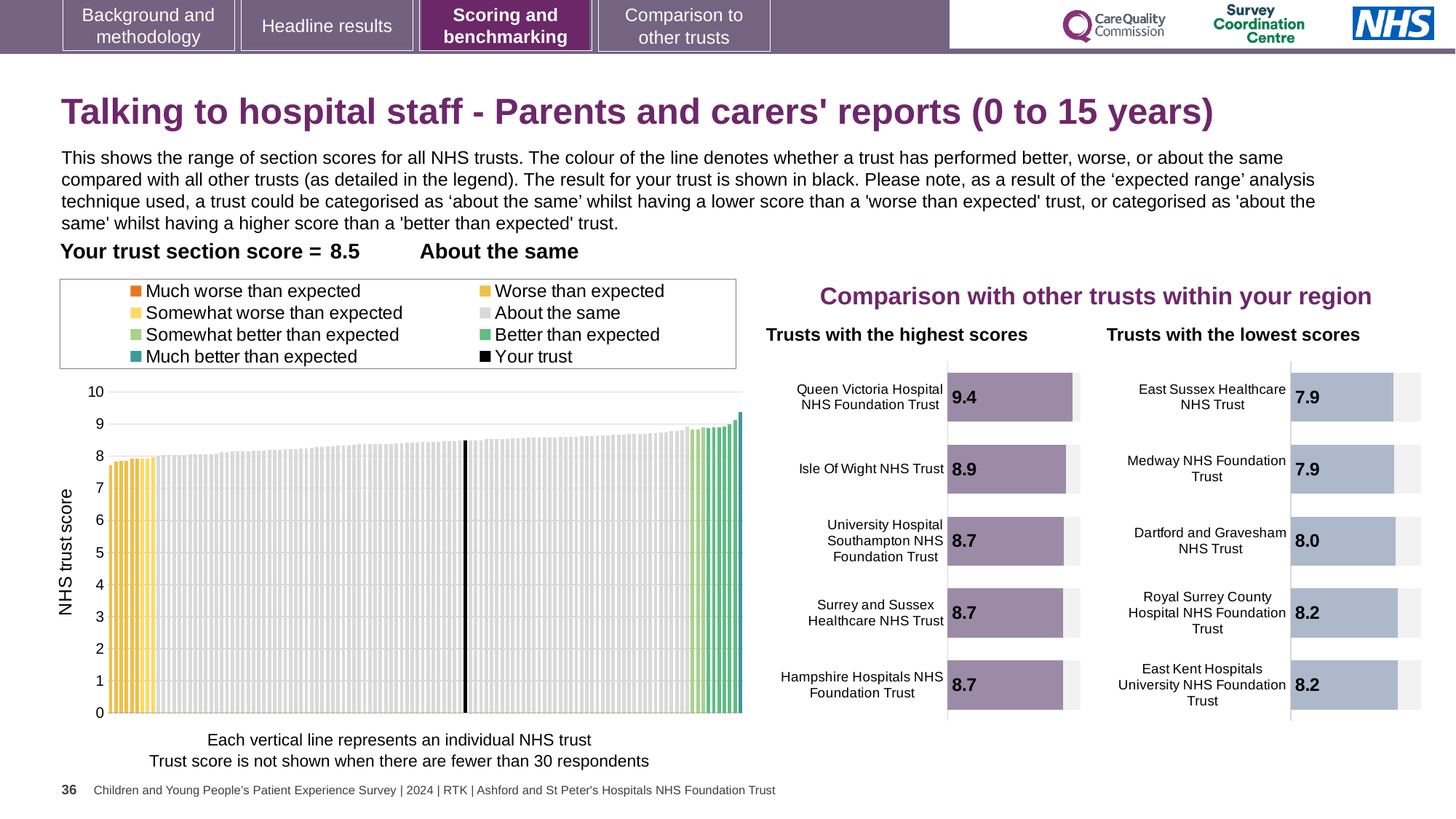
In the 'Trusts with the highest scores' chart, what is the score for Isle Of Wight NHS Trust? 8.9 How many trusts are listed in the 'Trusts with the lowest scores' chart? 5 In the 'Trusts with the highest scores' chart, what is the difference between the scores of Queen Victoria Hospital NHS Foundation Trust and Isle Of Wight NHS Trust? 0.5 What is the y-axis label of the large chart on the left? NHS trust score In the large chart on the left, is the value of the tallest bar greater or less than 9? greater In the 'Trusts with the highest scores' chart, which trust has the highest score? Queen Victoria Hospital NHS Foundation Trust In the 'Trusts with the lowest scores' chart, what is the score for Dartford and Gravesham NHS Trust? 8.0 In the 'Trusts with the lowest scores' chart, which has the larger score: Dartford and Gravesham NHS Trust or Royal Surrey County Hospital NHS Foundation Trust? Royal Surrey County Hospital NHS Foundation Trust In the 'Trusts with the highest scores' chart, what is the score for Queen Victoria Hospital NHS Foundation Trust? 9.4 In the 'Trusts with the lowest scores' chart, what is the difference between the scores of Royal Surrey County Hospital NHS Foundation Trust and Medway NHS Foundation Trust? 0.3 How many entries does the legend of the large chart on the left list? 8 In the 'Trusts with the lowest scores' chart, what is the score for East Kent Hospitals University NHS Foundation Trust? 8.2